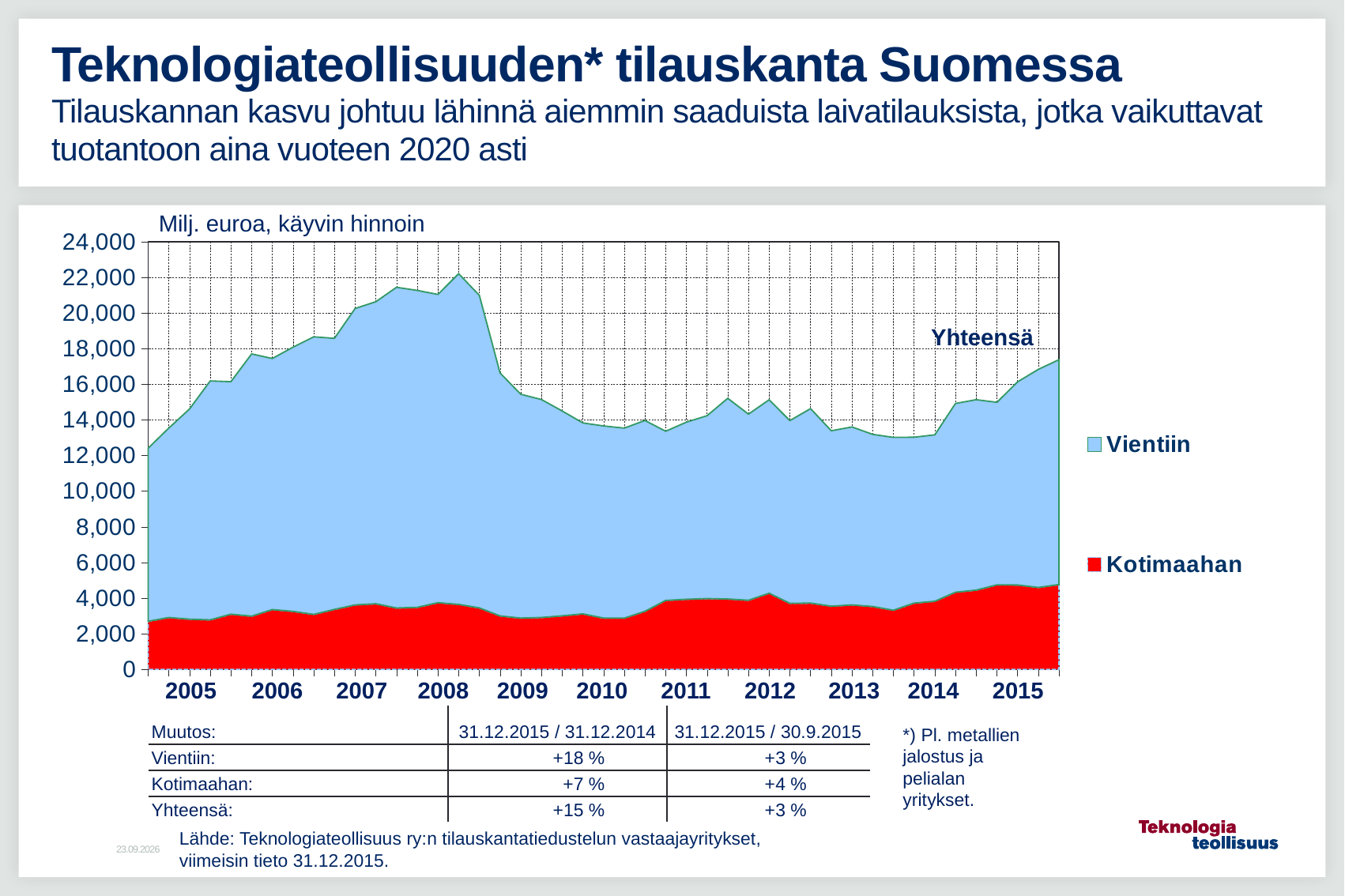
How many years are labelled on the x axis of the chart? 11 Is the total value in 2010 greater or less than 16,000? less In which year is the total (Yhteensä) at its lowest point? 2005 In which year does the total (Yhteensä) reach its highest point? 2008 Does the total (Yhteensä) rise or fall between 2008 and 2009? fall How many series does the chart legend list? 2 Which series is larger in 2010, Vientiin or Kotimaahan? Vientiin What unit label is shown above the chart's vertical axis? Milj. euroa, käyvin hinnoin Is the Kotimaahan value at the start of 2005 greater or less than 4,000? less Is the peak total value in 2008 greater or less than 20,000? greater Which two series are listed in the chart legend? Vientiin and Kotimaahan What kind of chart is shown on the slide? area chart